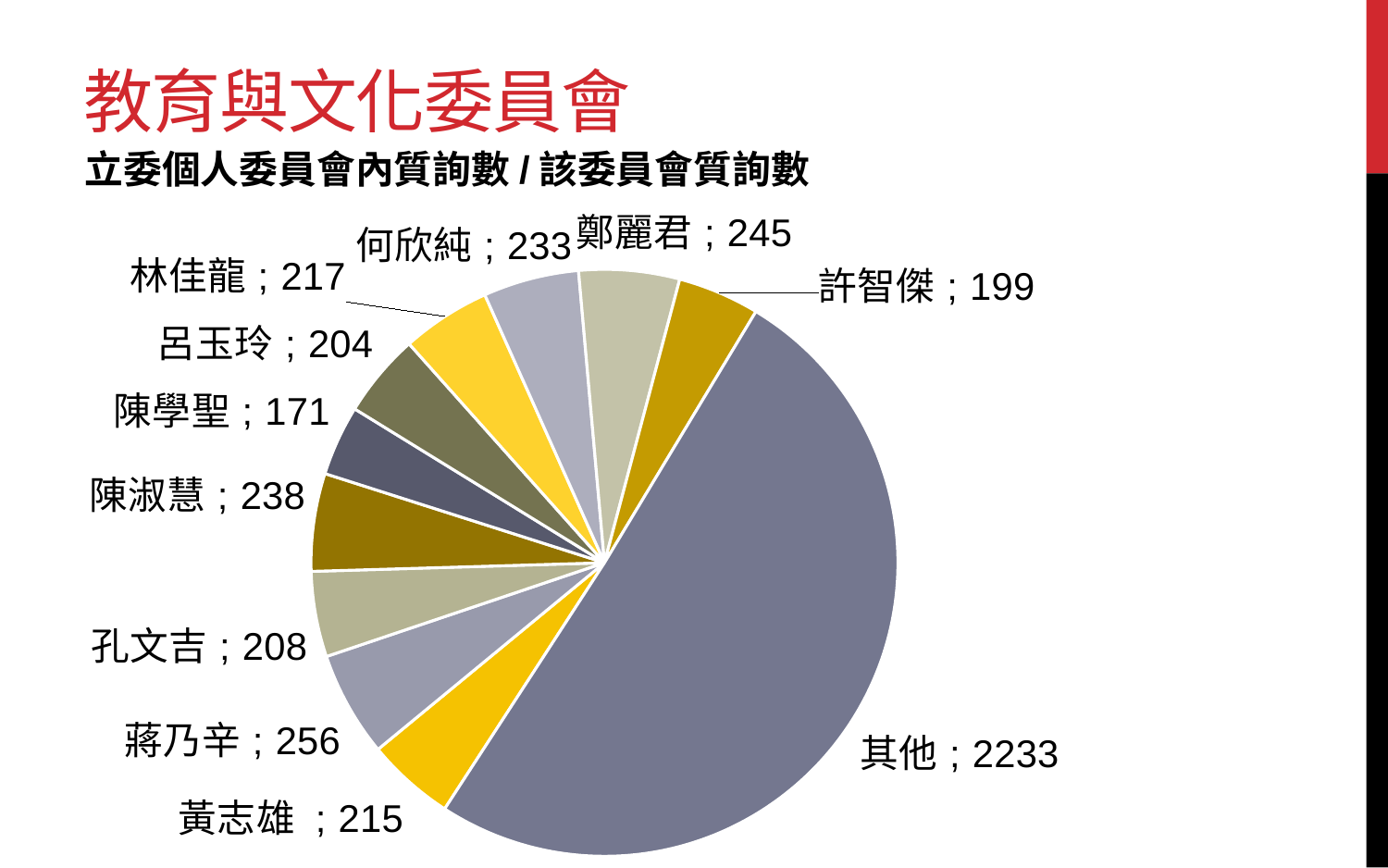
What kind of chart is shown on the slide? pie chart Which is larger, the value for 陳淑慧 or the value for 林佳龍? 陳淑慧 Which slice has the largest value? 其他 How many slices does the pie chart have? 11 What is the value for 許智傑? 199 What is the difference between the values for 鄭麗君 and 何欣純? 12 What is the value for 蔣乃辛? 256 Which slice has the smallest value? 陳學聖 What is the title of the slide? 教育與文化委員會 What is the value for 陳學聖? 171 What is the difference between the values for 蔣乃辛 and 陳學聖? 85 What is the value for 其他? 2233